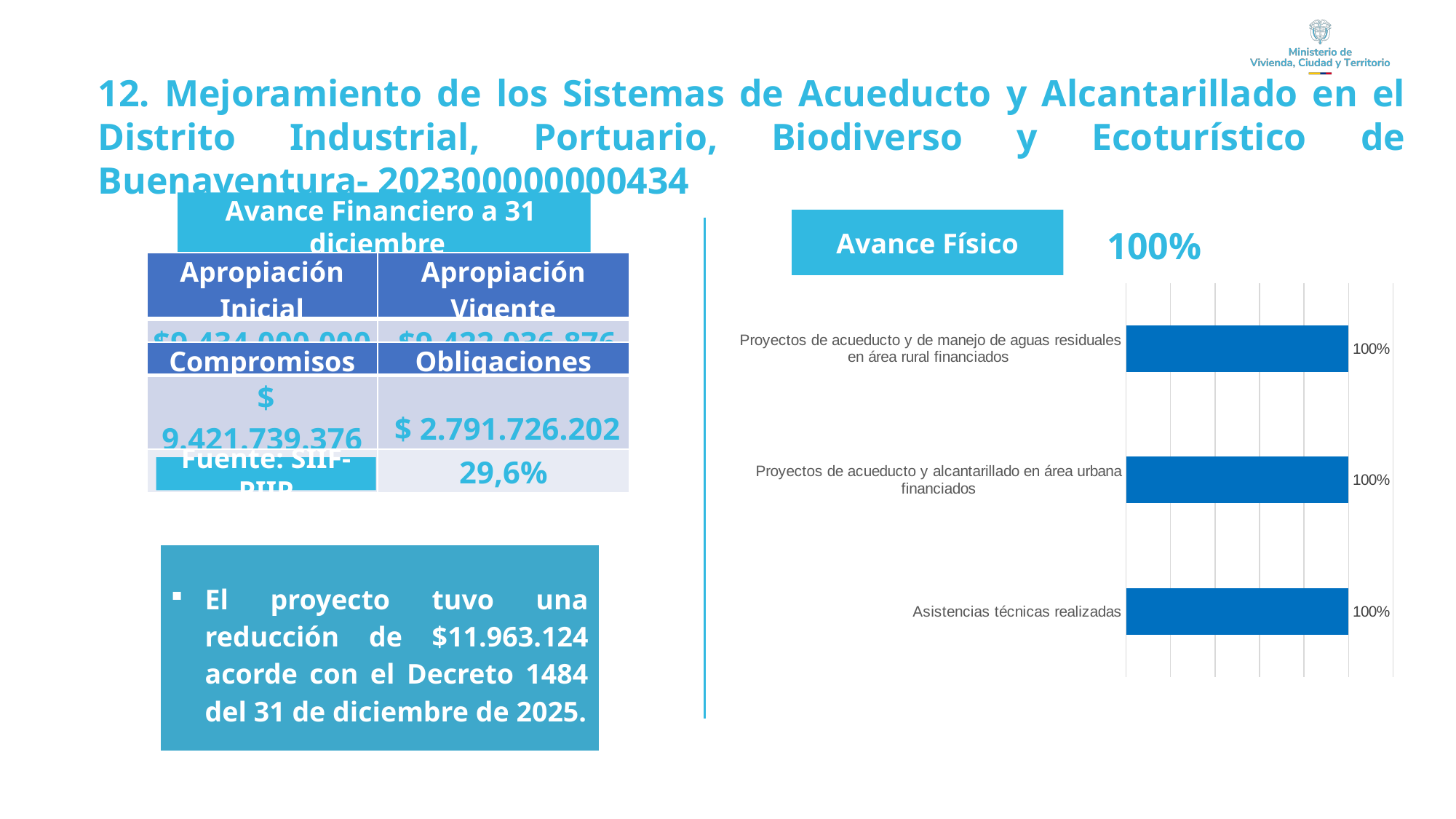
What value is shown for 'Proyectos de acueducto y de manejo de aguas residuales en área rural financiados' in the bar chart? 100% What value is shown for 'Proyectos de acueducto y alcantarillado en área urbana financiados' in the bar chart? 100% Do all three bars in the chart show the same value? Yes What heading appears above the bar chart? Avance Físico What value is shown for 'Asistencias técnicas realizadas' in the bar chart? 100% What is the difference between the value for 'Asistencias técnicas realizadas' and the value for 'Proyectos de acueducto y alcantarillado en área urbana financiados'? 0% How many categories are plotted in the bar chart? 3 What kind of chart is shown on the right side of the slide? bar chart